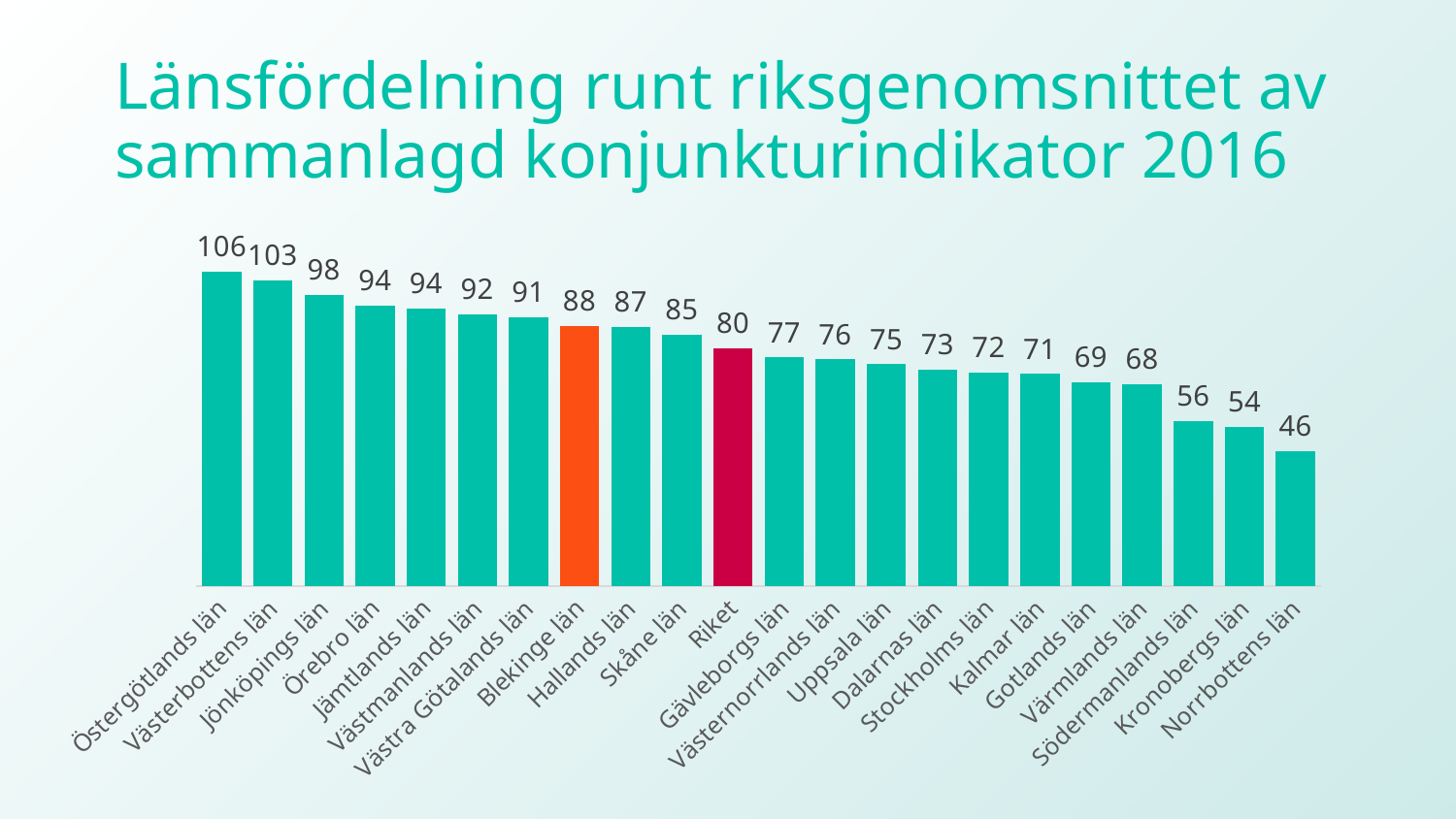
Which is larger, the value for Uppsala län or the value for Kalmar län? Uppsala län What is the value for Riket? 80 What kind of chart is shown on the slide? Bar chart Which county has the lowest value? Norrbottens län What is the value for Stockholms län? 72 What is the difference between the values for Östergötlands län and Norrbottens län? 60 How many bars are shown in the chart? 22 Which bar is coloured orange? Blekinge län Which county has the highest value? Östergötlands län Do the values rise or fall from left to right along the x axis? Fall What is the difference between the values for Blekinge län and Riket? 8 What is the value for Blekinge län? 88